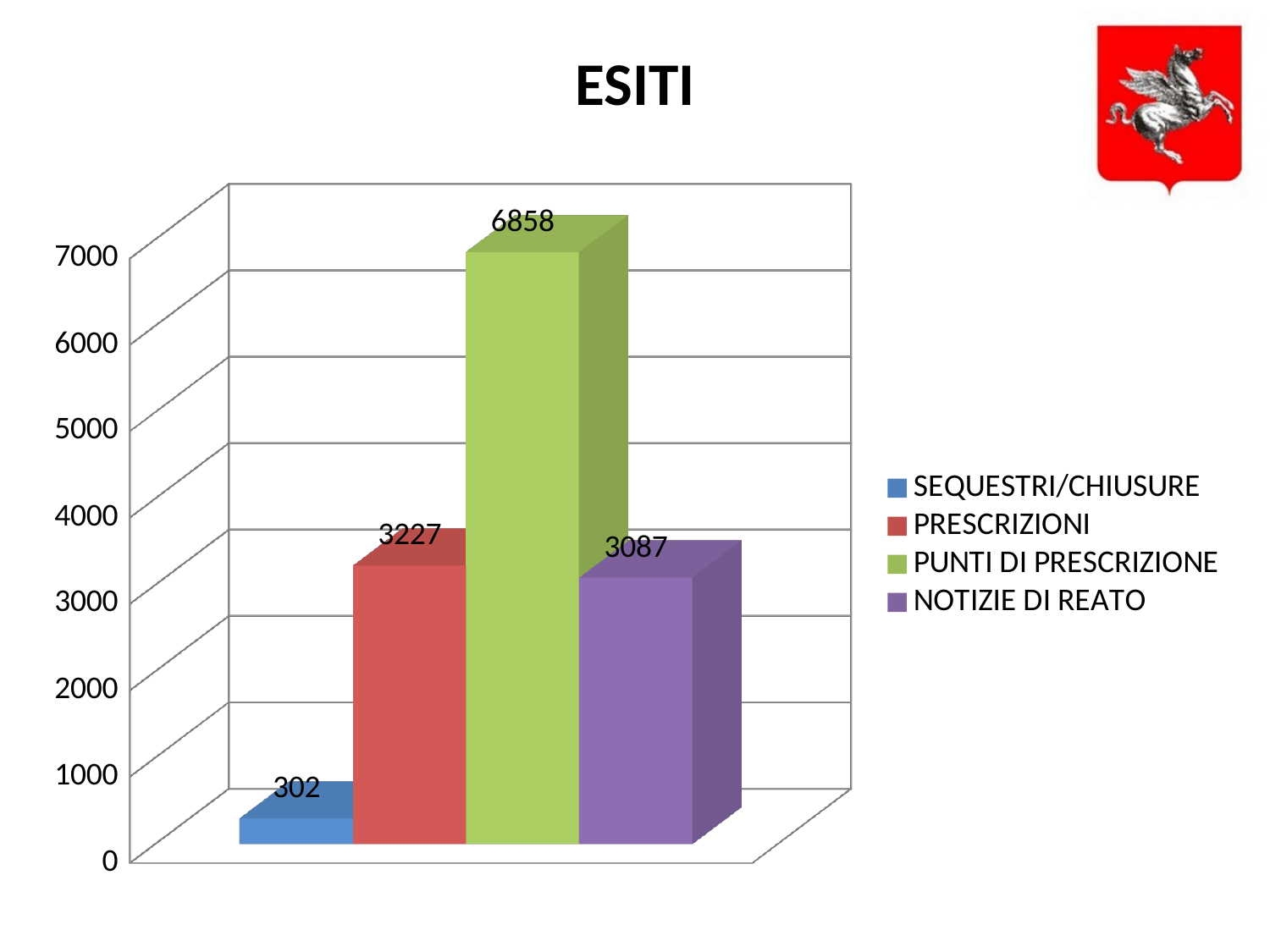
What is the difference between PUNTI DI PRESCRIZIONE and PRESCRIZIONI? 3631 Which category has the highest value? PUNTI DI PRESCRIZIONE What is the value for SEQUESTRI/CHIUSURE? 302 What is the difference between PRESCRIZIONI and NOTIZIE DI REATO? 140 What is the value for PRESCRIZIONI? 3227 How many categories does the legend list? 4 What is the title of the chart? ESITI What kind of chart is shown? bar chart What is the value for PUNTI DI PRESCRIZIONE? 6858 What is the value for NOTIZIE DI REATO? 3087 Which is larger, PRESCRIZIONI or NOTIZIE DI REATO? PRESCRIZIONI Which category has the lowest value? SEQUESTRI/CHIUSURE